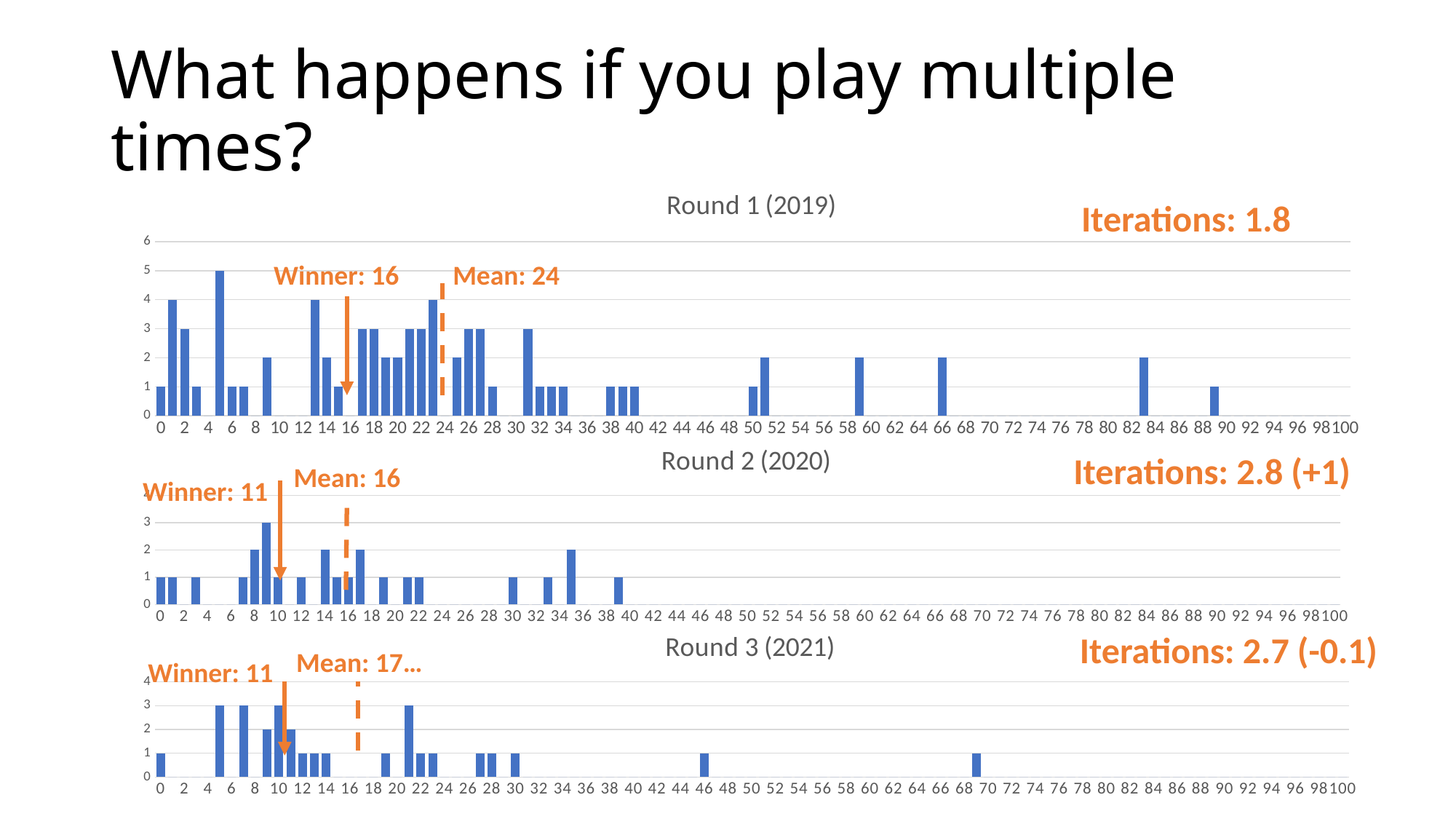
In the Round 3 (2021) chart, what is the winning number shown? 11 How many charts are shown on the slide? 3 In the Round 2 (2020) chart, which guess has the tallest bar? 9 What is the Iterations value shown for Round 2 (2020)? 2.8 (+1) In the Round 1 (2019) chart, what is the winning number shown? 16 In the Round 1 (2019) chart, is the bar for 1 taller or shorter than the bar for 2? taller In the Round 1 (2019) chart, what is the mean shown? 24 In the Round 1 (2019) chart, how many people guessed 5? 5 In the Round 1 (2019) chart, which guess has the tallest bar? 5 In the Round 3 (2021) chart, what is the highest value on the y axis? 4 What type of chart is used for Round 1 (2019)? bar chart In the Round 2 (2020) chart, what is the mean shown? 16